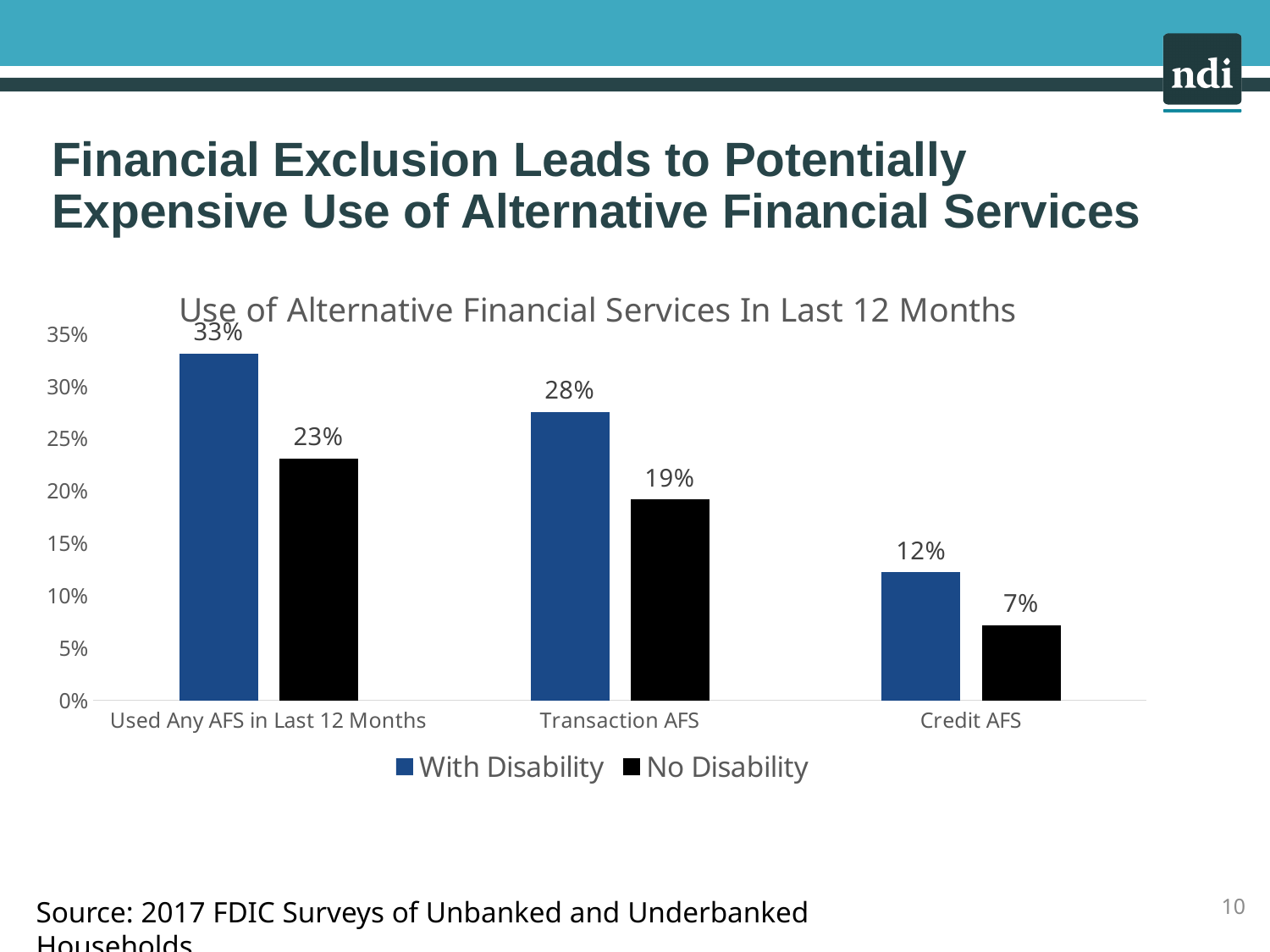
What is the value for With Disability in the Used Any AFS in Last 12 Months category? 33% How many categories are shown on the x axis? 3 What is the difference between With Disability and No Disability in the Transaction AFS category? 9% Is the value for With Disability in the Transaction AFS category greater or less than 25%? greater Which category has the lowest value for the No Disability series? Credit AFS What is the title of the chart? Use of Alternative Financial Services In Last 12 Months What kind of chart is shown on the slide? Bar chart How many series does the legend list? 2 What is the value for No Disability in the Credit AFS category? 7% Which category has the highest value for the With Disability series? Used Any AFS in Last 12 Months What is the value for No Disability in the Transaction AFS category? 19% Which is larger in the Credit AFS category: With Disability or No Disability? With Disability